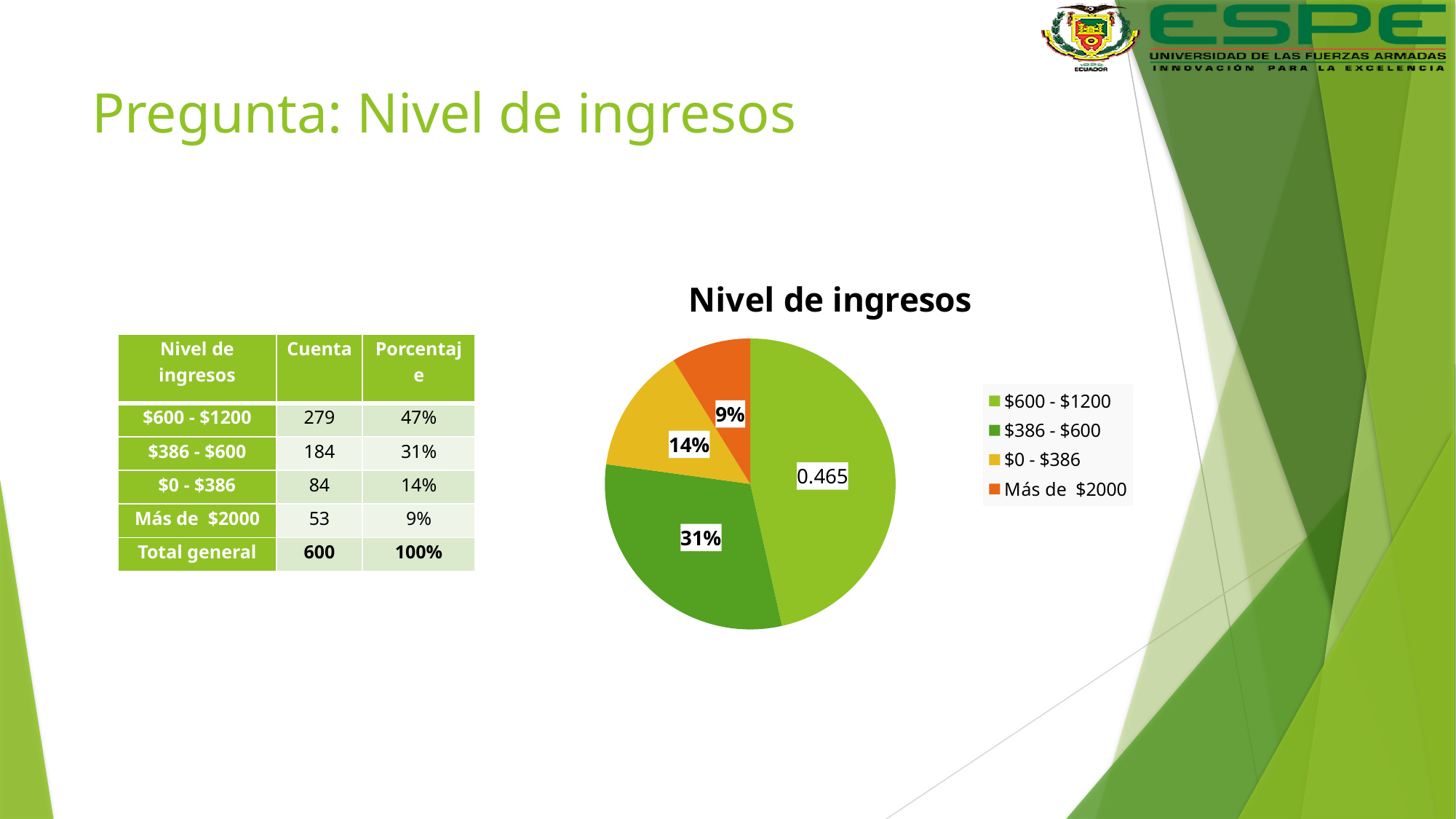
What data label is shown on the $600 - $1200 slice of the pie chart? 0.465 Which slice is larger in the pie chart, $0 - $386 or $386 - $600? $386 - $600 What data label is shown on the $0 - $386 slice of the pie chart? 14% How many entries does the chart legend list? 4 What is the title of the chart? Nivel de ingresos What kind of chart is shown on the slide? pie chart What data label is shown on the $386 - $600 slice of the pie chart? 31% Which category has the smallest slice in the pie chart? Más de $2000 What is the difference in percentage points between the $386 - $600 slice and the $0 - $386 slice? 17% What data label is shown on the Más de $2000 slice of the pie chart? 9% Which category has the largest slice in the pie chart? $600 - $1200 How many slices does the pie chart have? 4